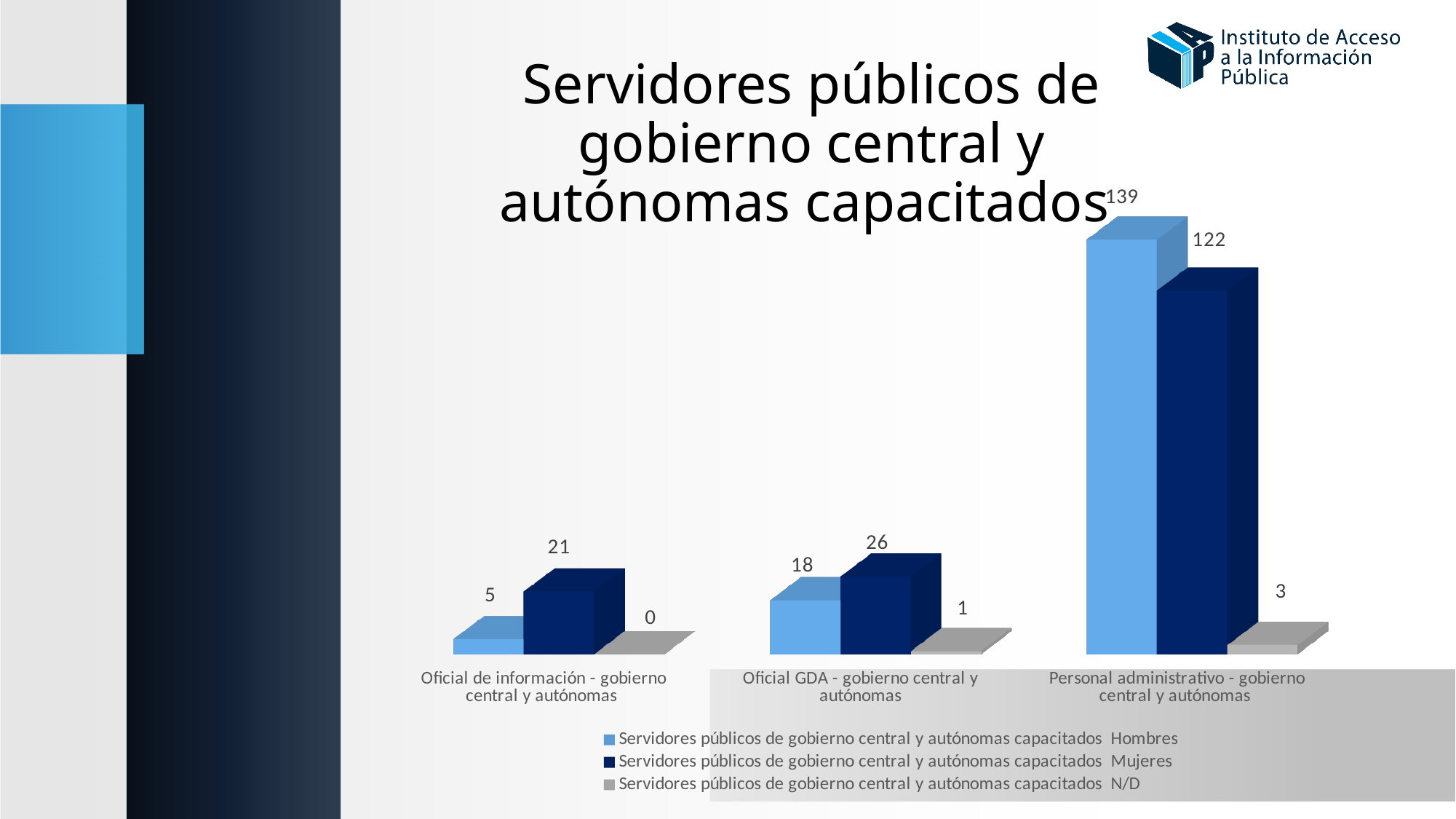
What is the value for Hombres in the 'Personal administrativo - gobierno central y autónomas' category? 139 What colour are the bars for the Mujeres series? Dark blue What is the value for Hombres in the 'Oficial de información - gobierno central y autónomas' category? 5 How many categories are shown on the x axis of the chart? 3 How many series does the chart legend list? 3 What is the value for Mujeres in the 'Oficial GDA - gobierno central y autónomas' category? 26 What kind of chart is shown on the slide? Bar chart In the 'Oficial GDA - gobierno central y autónomas' category, which is larger: the Hombres value or the Mujeres value? Mujeres Which category has the lowest value for Hombres? Oficial de información - gobierno central y autónomas Which category has the highest value for Mujeres? Personal administrativo - gobierno central y autónomas What is the difference between the Hombres and Mujeres values in the 'Personal administrativo - gobierno central y autónomas' category? 17 What is the value for N/D in the 'Oficial de información - gobierno central y autónomas' category? 0